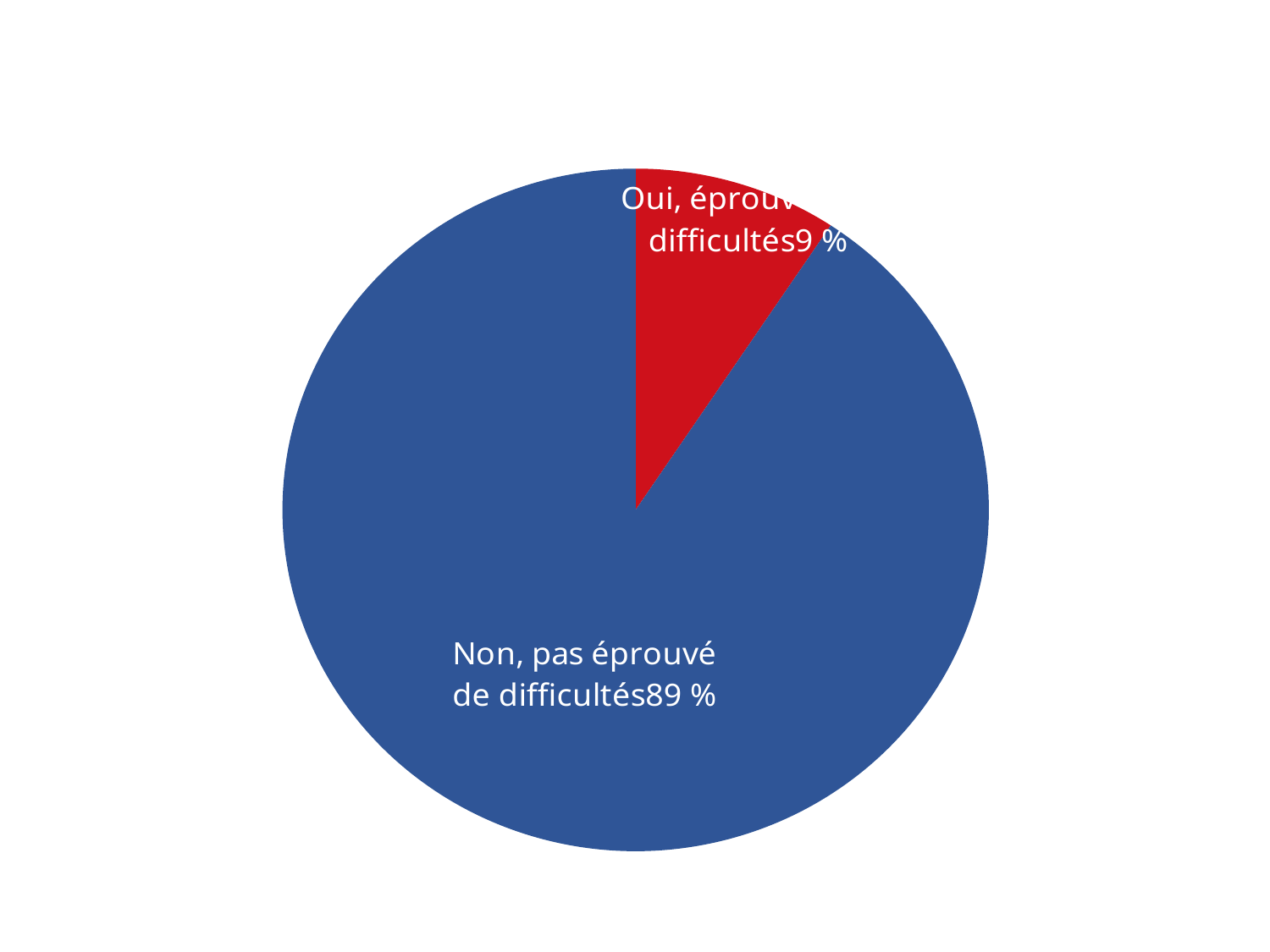
What percentage is shown for the red slice ("Oui, éprouvé de difficultés")? 9 % Which slice of the pie is the largest? Non, pas éprouvé de difficultés Which slice is larger: "Non, pas éprouvé de difficultés" or "Oui, éprouvé de difficultés"? Non, pas éprouvé de difficultés Which slice of the pie is the smallest? Oui, éprouvé de difficultés What percentage is shown for the slice "Non, pas éprouvé de difficultés"? 89 % What colour is the "Non, pas éprouvé de difficultés" slice? blue What kind of chart is shown on the slide? pie chart What share of the pie does the "Non, pas éprouvé de difficultés" slice represent? 89 % How many slices does the pie chart have? 2 What colour is the "Oui, éprouvé de difficultés" slice? red What is the difference in percentage points between the "Non, pas éprouvé de difficultés" slice and the "Oui" slice? 80 %